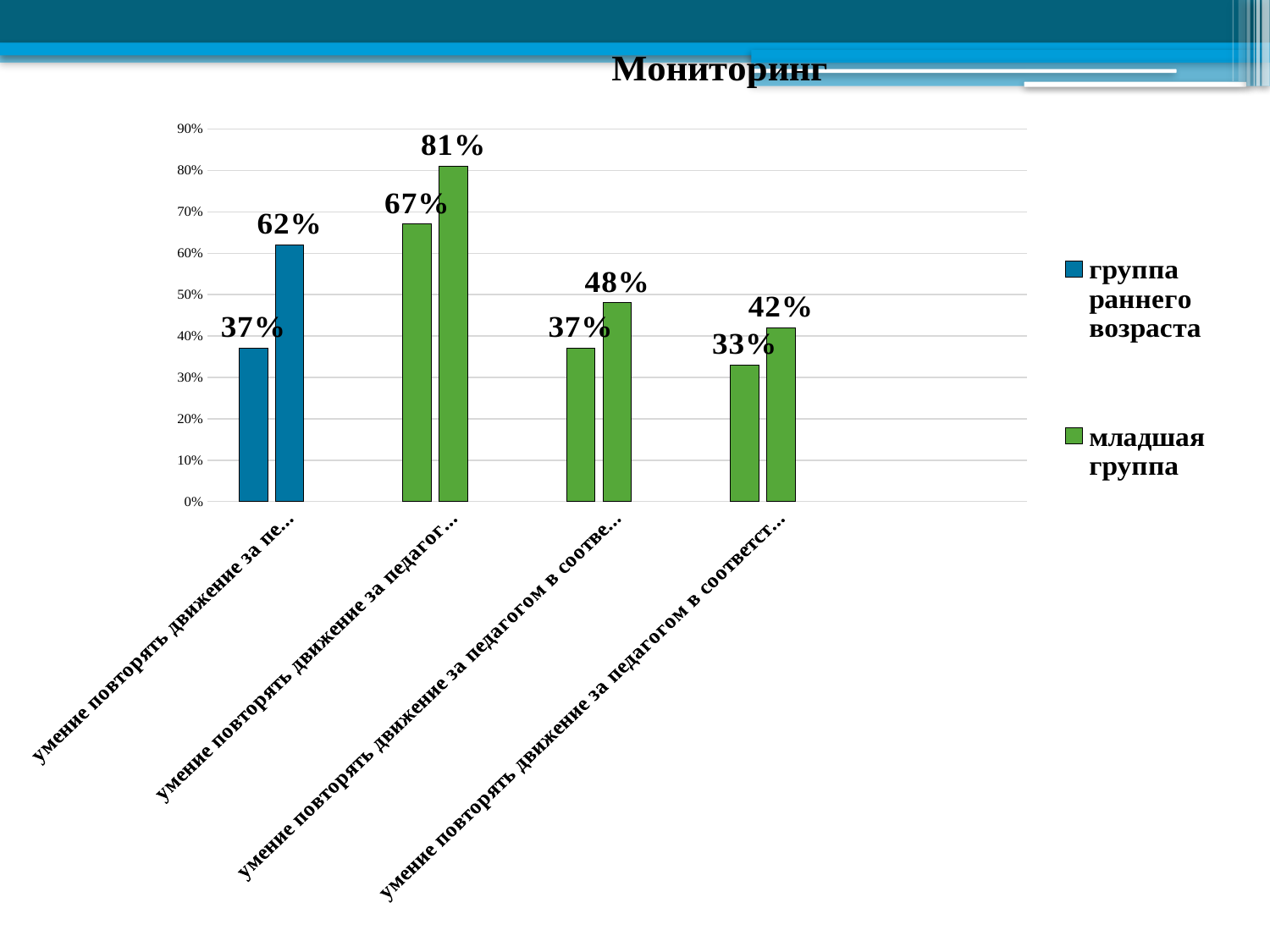
How many series does the legend list? 2 What is the title of the chart? Мониторинг What kind of chart is shown on the slide? bar chart What is the value of the left bar in the second category from the left? 67% What is the lowest value shown on the chart? 33% What is the highest value shown on the chart? 81% What is the value of the taller (right) bar in the first category from the left? 62% Which is larger: the right bar of the third category (48%) or the right bar of the fourth category (42%)? 48% Which legend entry is shown in blue? группа раннего возраста What is the difference between the two bars in the first category from the left (62% and 37%)? 25% How many categories are shown along the x axis? 4 What is the value of the right bar in the fourth category from the left? 42%